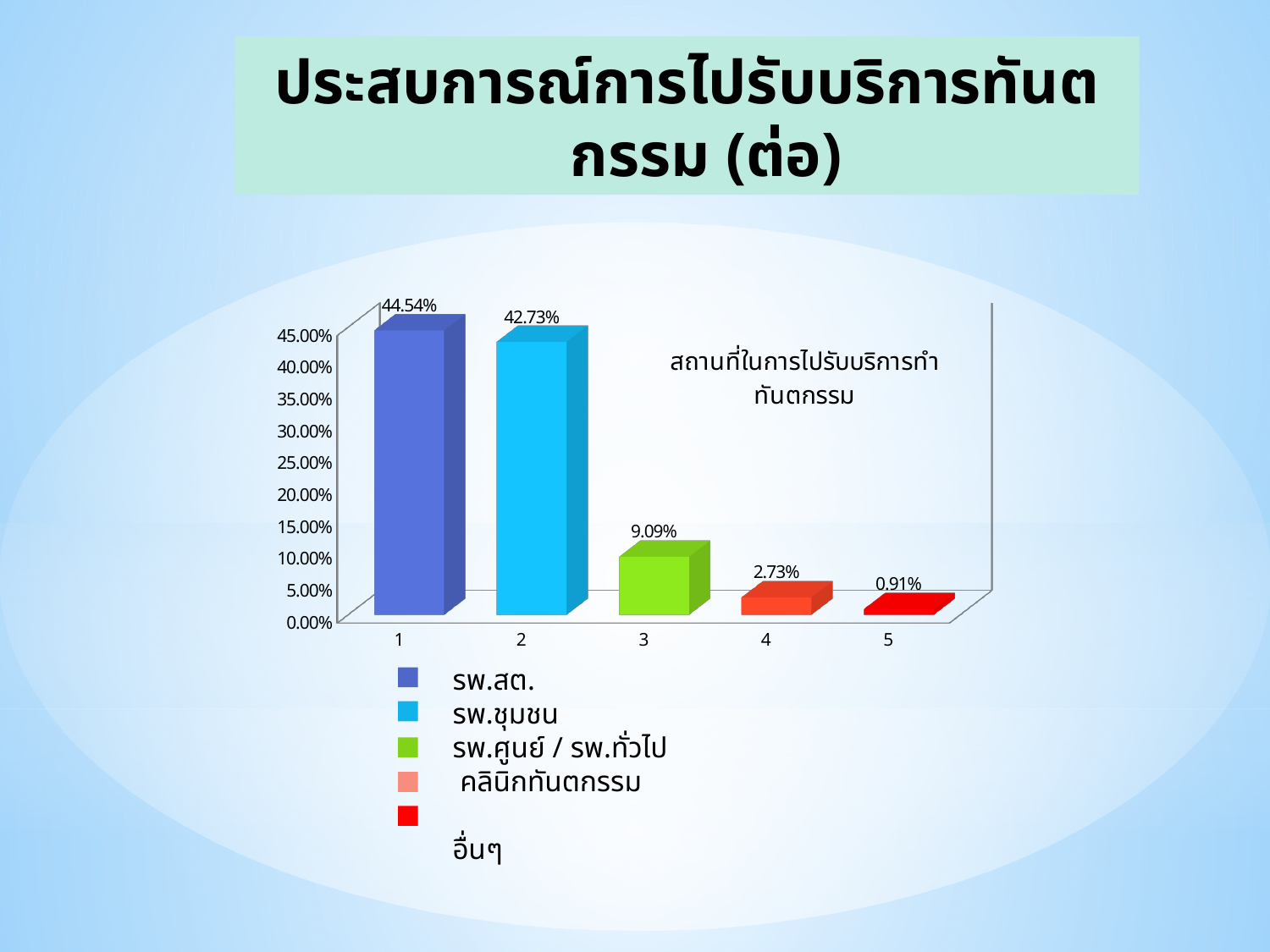
What kind of chart is shown on the slide? bar chart How many bars are plotted in the chart? 5 What is the value shown for category 3 (รพ.ศูนย์ / รพ.ทั่วไป)? 9.09% What is the difference between the values for category 1 and category 2? 1.81% What is the value shown for category 1 (รพ.สต.)? 44.54% Which category has the highest value? 1 (รพ.สต.) Which is larger, the value for category 3 or the value for category 4? category 3 What is the difference between the values for category 3 and category 4? 6.36% What is the value shown for category 5 (อื่นๆ)? 0.91% What is the value shown for category 2 (รพ.ชุมชน)? 42.73% Which category has the lowest value? 5 (อื่นๆ) Do the values rise or fall from category 1 to category 5? fall